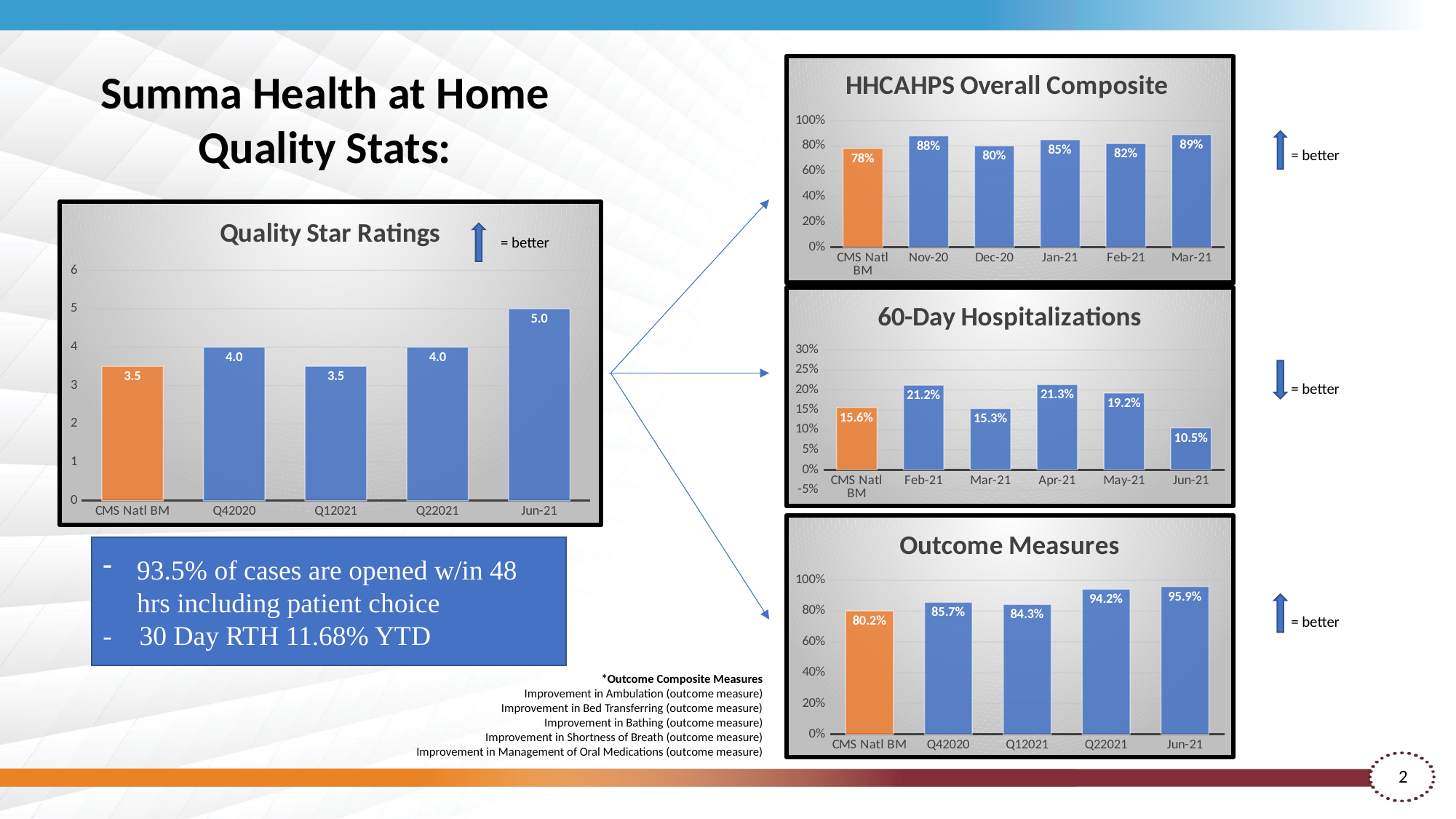
What kind of chart is the Outcome Measures chart? Bar chart In the HHCAHPS Overall Composite chart, which category has the highest value? Mar-21 In the 60-Day Hospitalizations chart, which is larger, Feb-21 or May-21? Feb-21 In the 60-Day Hospitalizations chart, what is the value for Jun-21? 10.5% In the Outcome Measures chart, what is the value for Q22021? 94.2% In the Outcome Measures chart, what is the difference between Jun-21 and Q12021? 11.6% In the Quality Star Ratings chart, how many categories are shown on the x axis? 5 In the HHCAHPS Overall Composite chart, what is the difference between Mar-21 and CMS Natl BM? 11% In the Quality Star Ratings chart, which category has the highest value? Jun-21 In the HHCAHPS Overall Composite chart, what is the value for CMS Natl BM? 78% In the Quality Star Ratings chart, what is the value for Jun-21? 5.0 In the 60-Day Hospitalizations chart, which category has the lowest value? Jun-21